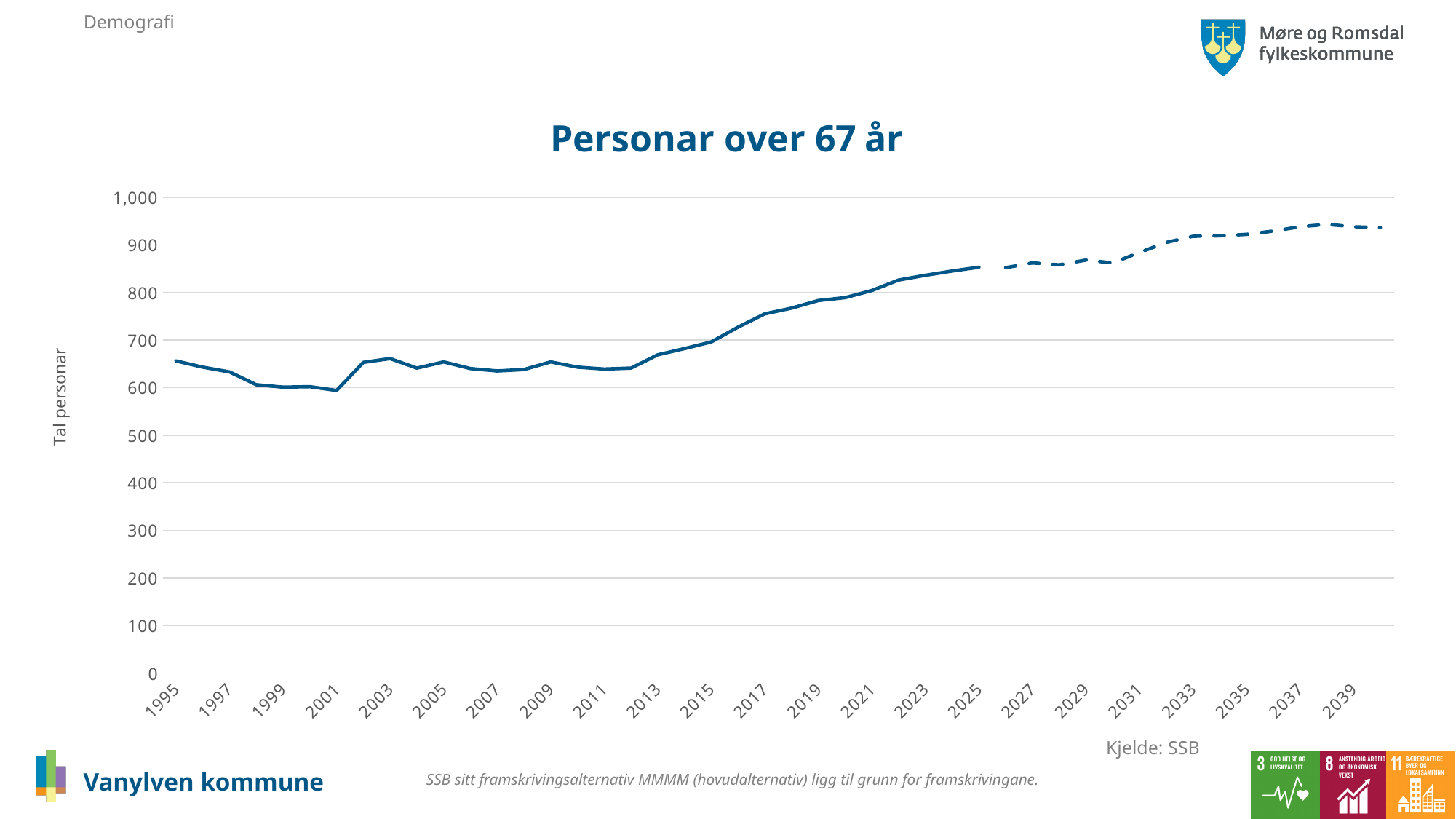
What kind of chart is shown on the slide? line chart What is the label on the vertical axis of the chart? Tal personar Is the value for 1995 greater or less than 600? greater Does the line rise or fall between 2013 and 2025? rise Is the value for 2025 greater or less than 800? greater What is the title of the chart? Personar over 67 år Which is larger, the value for 2025 or the value for 2001? 2025 Is the value for 2039 greater or less than 900? greater Which year shows the lowest value on the chart? 2001 How many year labels are shown on the horizontal axis? 23